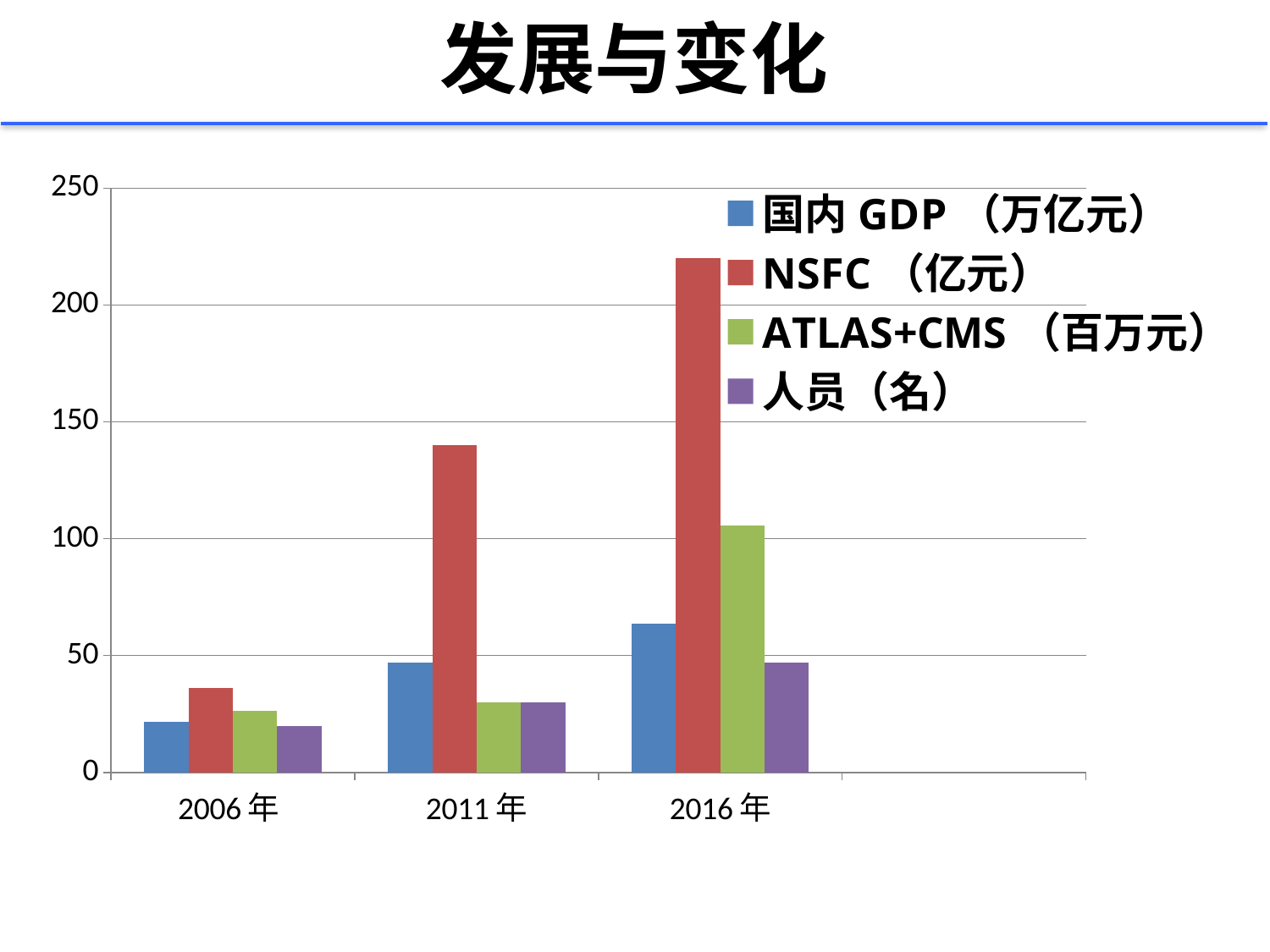
Is the value for NSFC（亿元） in 2011 年 greater or less than 150? less Which series has the tallest bar in 2016 年? NSFC（亿元） In 2011 年, which is larger: NSFC（亿元） or ATLAS+CMS（百万元）? NSFC（亿元） How many series does the legend list? 4 Is the value for 人员（名） in 2011 年 greater or less than 50? less How many year categories are shown on the x axis? 3 Is the value for 国内 GDP（万亿元） in 2016 年 greater or less than 50? greater What kind of chart is shown on the slide? bar chart Do the NSFC（亿元） values rise or fall from 2006 年 to 2016 年? rise Which series has the shortest bar in 2006 年? 人员（名） What is the title of the slide? 发展与变化